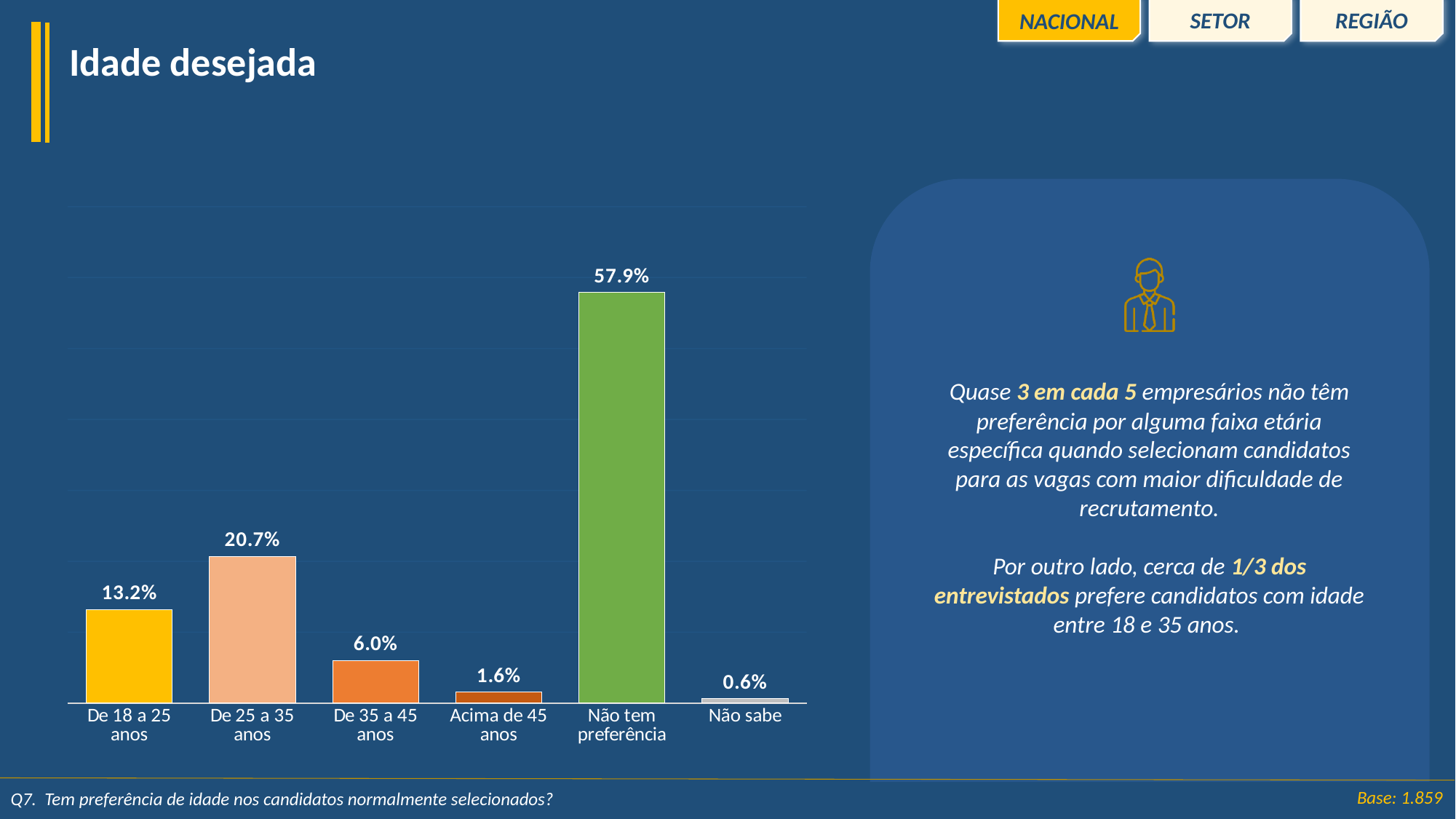
How many categories are shown on the chart? 6 What is the value for "Não tem preferência"? 57.9% Which category has the highest value? Não tem preferência What is the combined value of "De 18 a 25 anos" and "De 25 a 35 anos"? 33.9% What is the value for "De 25 a 35 anos"? 20.7% What is the difference between "De 25 a 35 anos" and "De 18 a 25 anos"? 7.5% Which category has the lowest value? Não sabe What is the value for "Acima de 45 anos"? 1.6% What kind of chart is shown on the slide? Bar chart What is the value for "De 18 a 25 anos"? 13.2% What is the title of the slide containing the chart? Idade desejada Which is larger, "De 35 a 45 anos" or "Acima de 45 anos"? De 35 a 45 anos